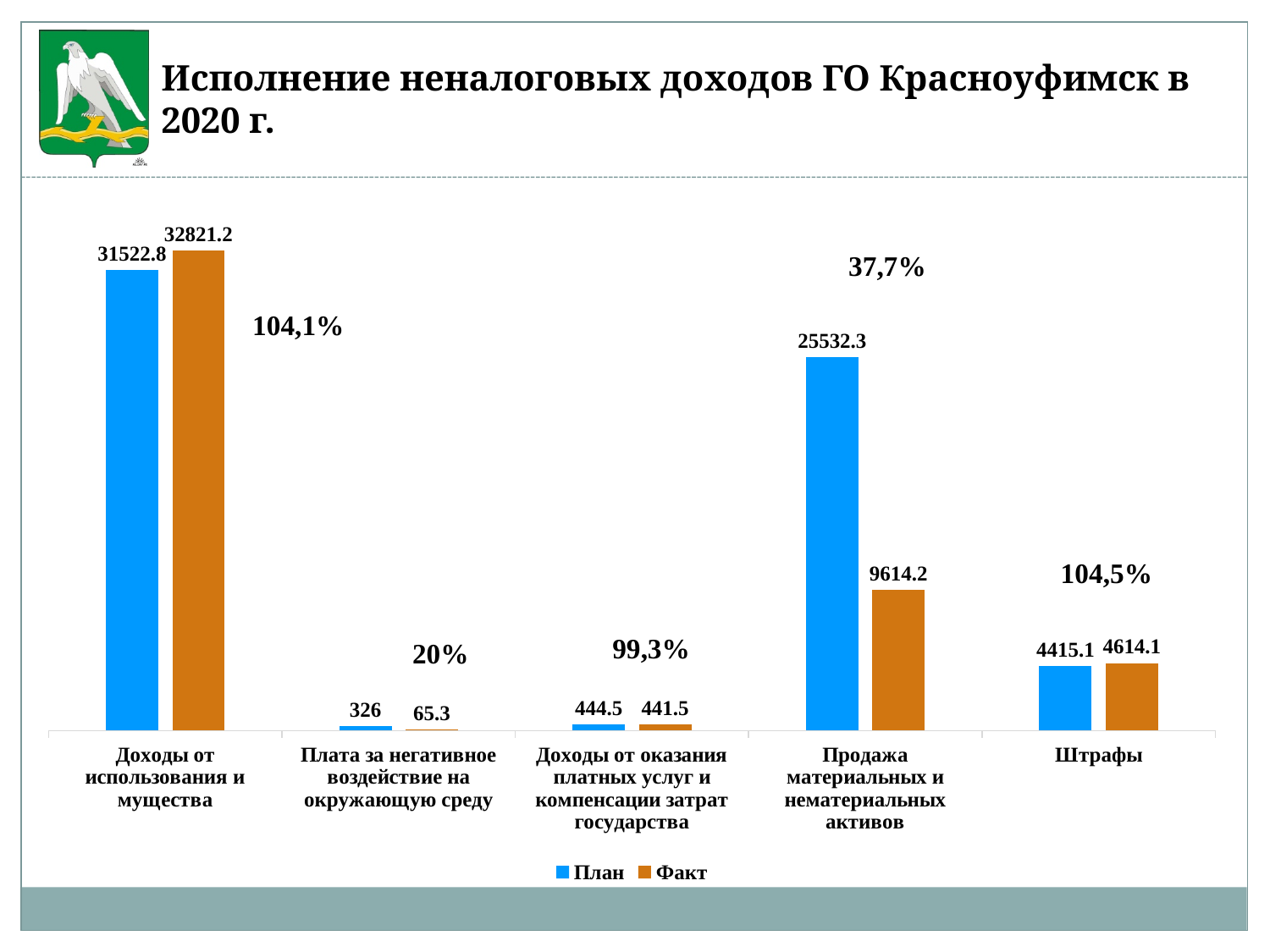
What is the План value for Доходы от оказания платных услуг и компенсации затрат государства? 444.5 Which category has the lowest План value? Плата за негативное воздействие на окружающую среду What is the difference between the Факт and План values for Штрафы? 199 What kind of chart is shown on the slide? Bar chart What is the Факт value for Плата за негативное воздействие на окружающую среду? 65.3 Which is larger for Доходы от использования имущества, the План value or the Факт value? Факт How many categories are shown on the x axis? 5 What is the difference between the План and Факт values for Продажа материальных и нематериальных активов? 15918.1 What is the Факт value for Продажа материальных и нематериальных активов? 9614.2 What is the План value for Штрафы? 4415.1 Which category has the highest Факт value? Доходы от использования и мущества How many series does the legend list? 2